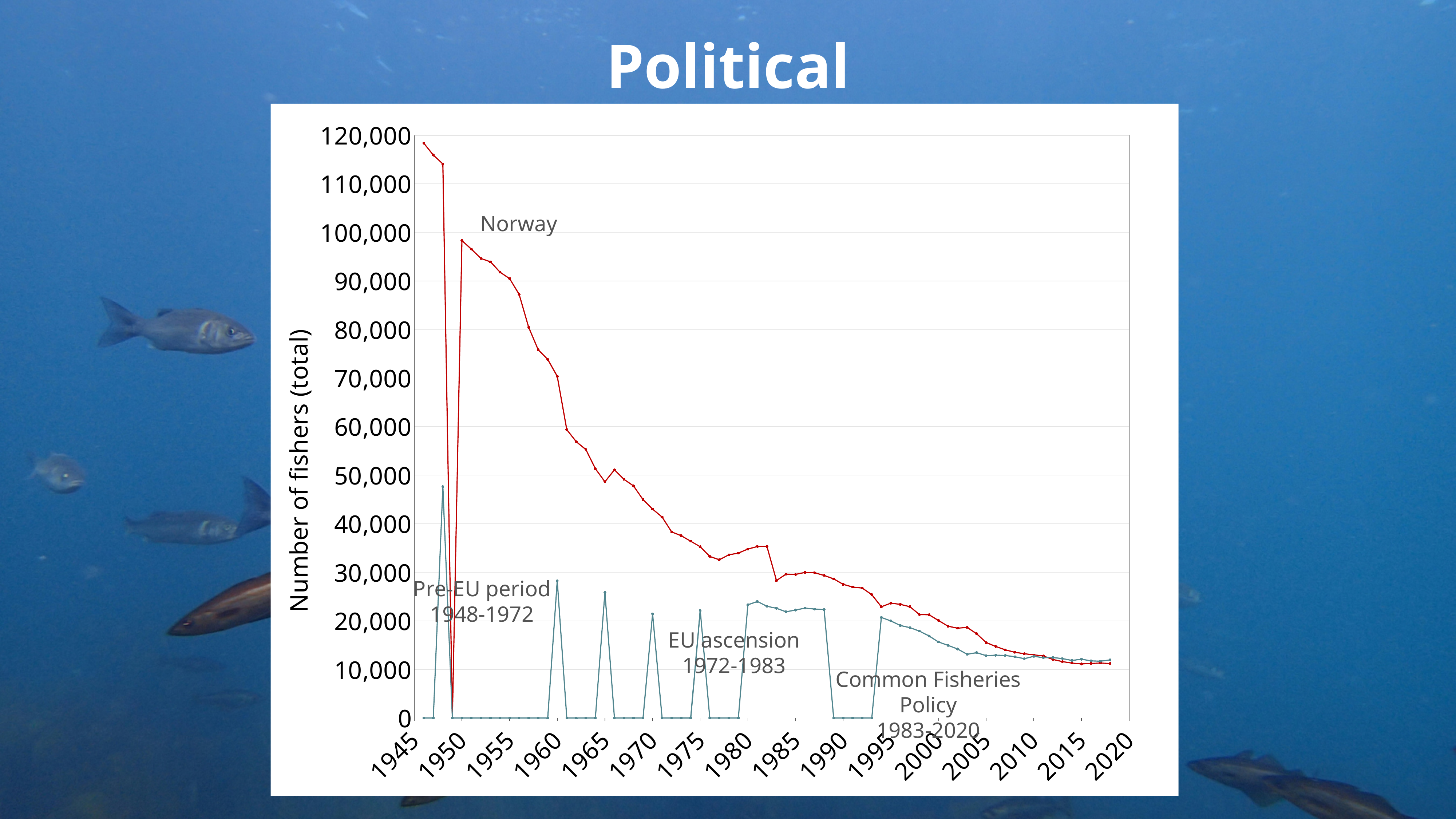
Is the peak value of the teal series around 1949 greater or less than 40,000? greater What kind of chart is shown on the slide? line chart In 1980, which series has the larger value, Norway (red) or the teal series? Norway Is the value for Norway in 1965 greater or less than 60,000? less Is the value for Norway in 1975 greater or less than 40,000? less Does the Norway series generally rise or fall from 1950 to 2020? fall What is the label on the vertical axis of the chart? Number of fishers (total) Which series is labelled directly on the chart next to the red line? Norway